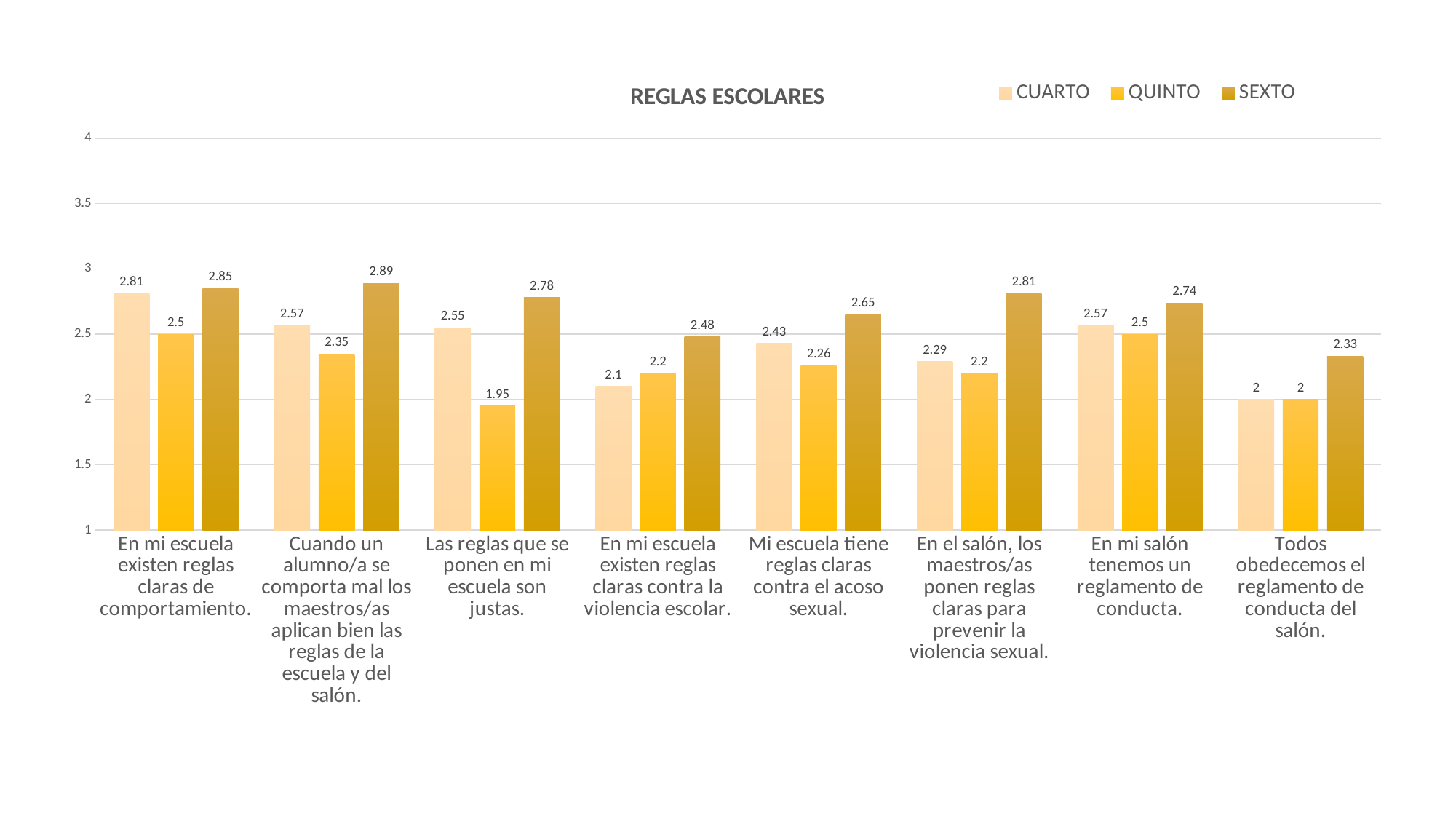
How many series does the legend list? 3 What is the SEXTO value for "Mi escuela tiene reglas claras contra el acoso sexual."? 2.65 Is the SEXTO value for "Todos obedecemos el reglamento de conducta del salón." greater or less than 2.5? less What is the CUARTO value for "En mi escuela existen reglas claras de comportamiento."? 2.81 What is the title of the chart? REGLAS ESCOLARES Which category has the highest SEXTO value? Cuando un alumno/a se comporta mal los maestros/as aplican bien las reglas de la escuela y del salón. Which category has the lowest QUINTO value? Las reglas que se ponen en mi escuela son justas. What kind of chart is shown? bar chart For "En mi escuela existen reglas claras contra la violencia escolar.", which is larger, the CUARTO value or the QUINTO value? QUINTO How many categories are shown on the x axis? 8 What is the difference between the SEXTO and QUINTO values for "Las reglas que se ponen en mi escuela son justas."? 0.83 What is the QUINTO value for "Las reglas que se ponen en mi escuela son justas."? 1.95